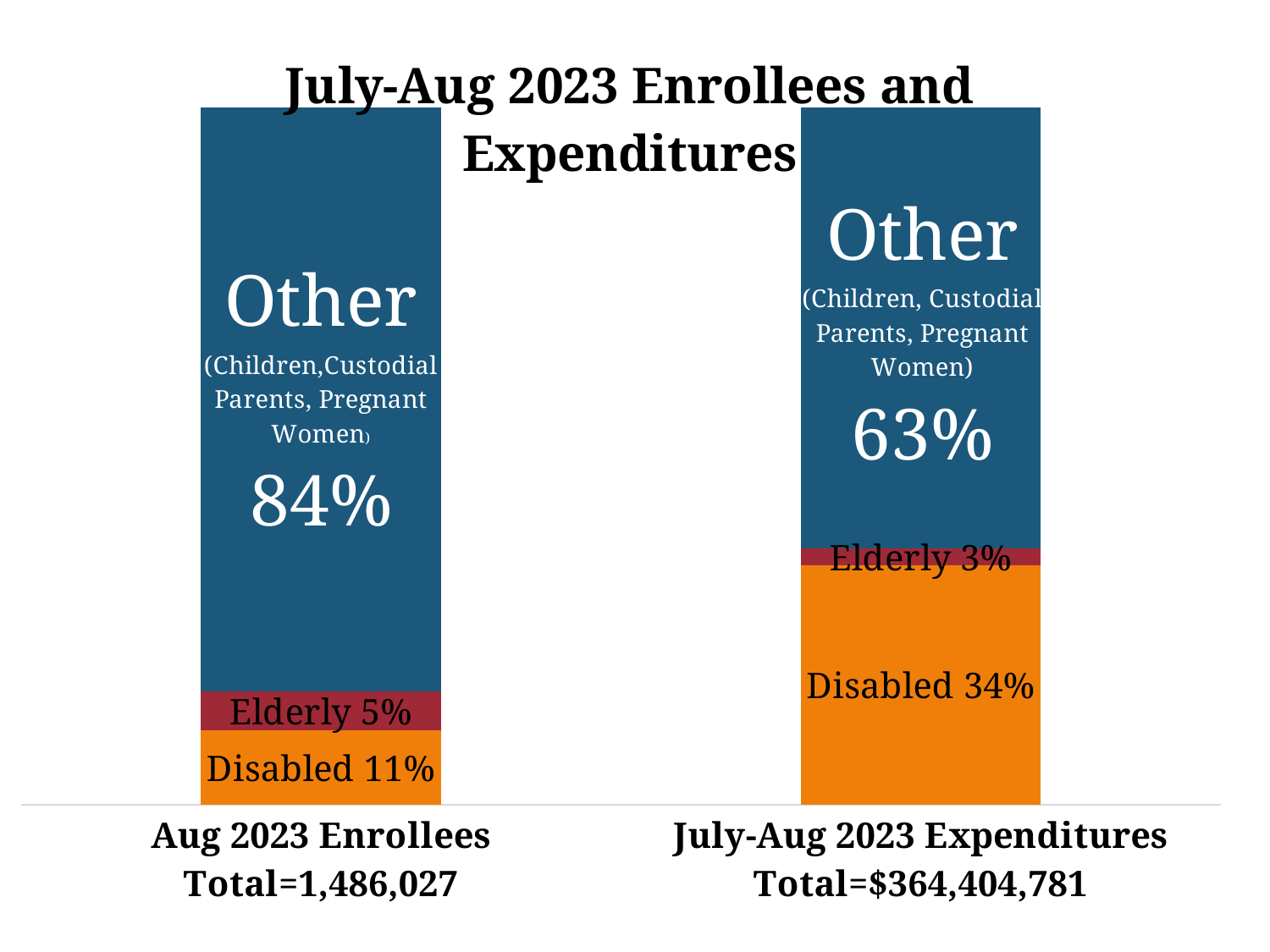
What kind of chart is shown on the slide? Stacked bar chart What share of July-Aug 2023 Expenditures is Disabled? 34% What is the total number of Aug 2023 Enrollees shown on the slide? 1,486,027 What share of Aug 2023 Enrollees is Disabled? 11% What is the total of July-Aug 2023 Expenditures shown on the slide? $364,404,781 Is the Other share larger for Aug 2023 Enrollees or for July-Aug 2023 Expenditures? Aug 2023 Enrollees Which group has the smallest share of July-Aug 2023 Expenditures? Elderly What share of Aug 2023 Enrollees is Elderly? 5% What is the chart's title? July-Aug 2023 Enrollees and Expenditures Which group has the largest share of Aug 2023 Enrollees? Other (Children, Custodial Parents, Pregnant Women) What is the difference between the Disabled share of July-Aug 2023 Expenditures and the Disabled share of Aug 2023 Enrollees? 23 percentage points What share of July-Aug 2023 Expenditures is Other (Children, Custodial Parents, Pregnant Women)? 63%